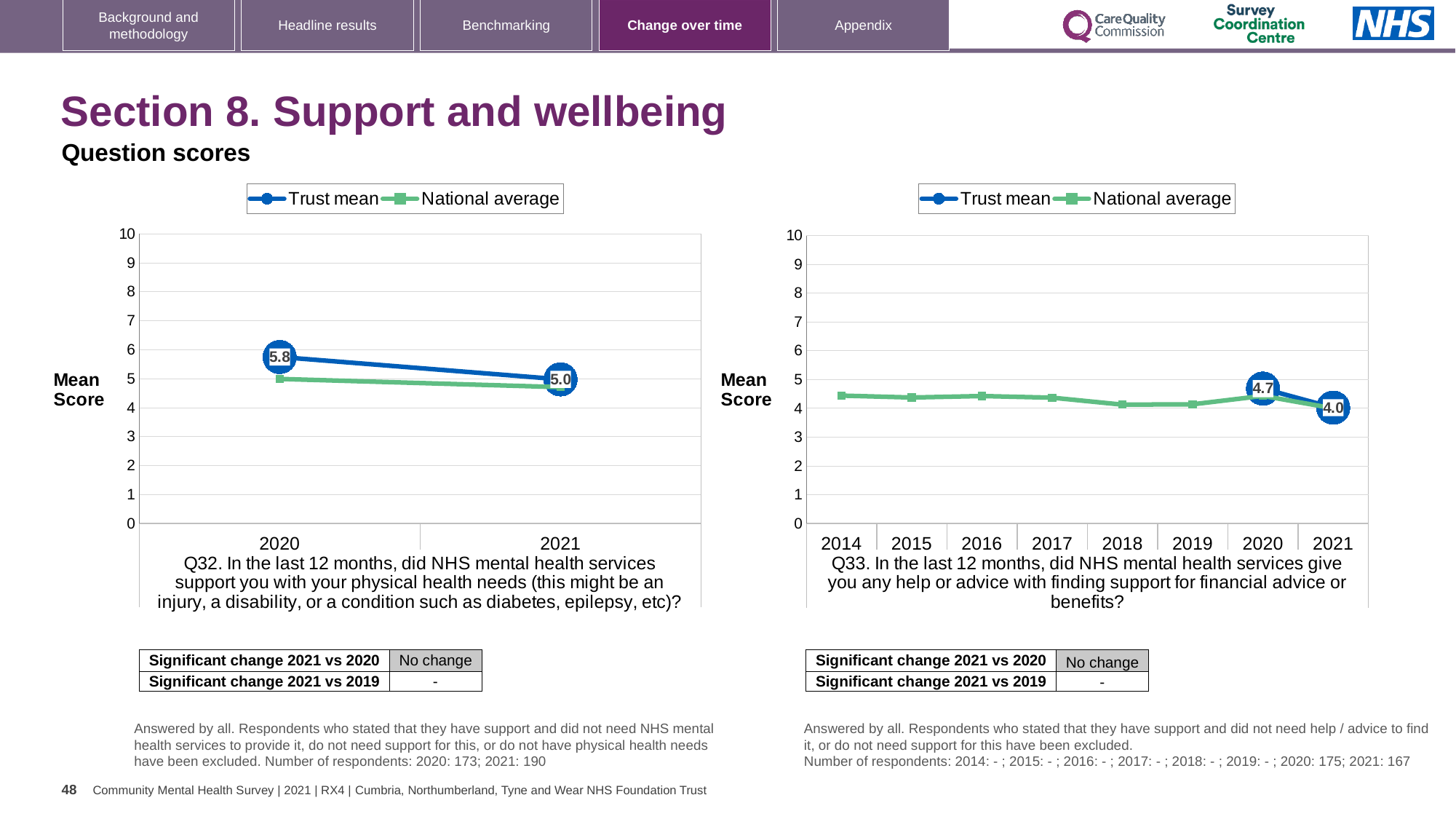
In the right chart (Q33), does the Trust mean rise or fall from 2020 to 2021? fall In the left chart (Q32), which year has the higher Trust mean, 2020 or 2021? 2020 In the left chart (Q32), what is the Trust mean for 2021? 5.0 What kind of chart is the left chart (Q32)? line chart In the right chart (Q33), by how much did the Trust mean fall from 2020 to 2021? 0.7 How many years are shown on the x axis of the right chart (Q33)? 8 How many series does the legend of the right chart (Q33) list? 2 In the right chart (Q33), what is the Trust mean for 2021? 4.0 In the right chart (Q33), what is the Trust mean for 2020? 4.7 In the left chart (Q32), what is the Trust mean for 2020? 5.8 In the left chart (Q32), what is the difference between the Trust mean in 2020 and in 2021? 0.8 In the right chart (Q33), is the National average for 2014 greater or less than 5? less